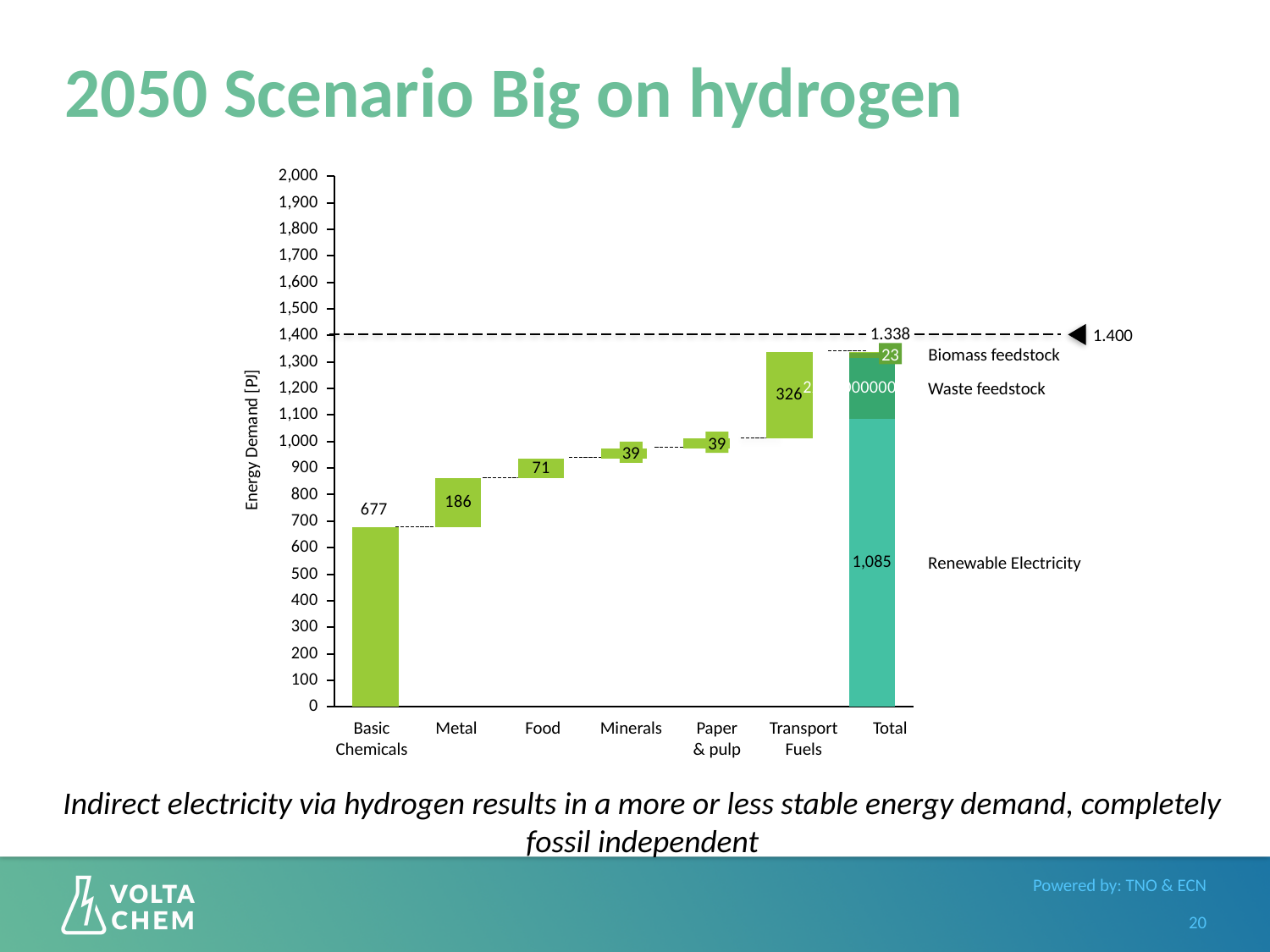
Which sector has the highest energy demand value? Basic Chemicals Is the Total value greater or less than 1,400? less What is the value shown above the Total bar? 1.338 What is the value for Basic Chemicals? 677 What is the value for Transport Fuels? 326 What is the Biomass feedstock value in the Total bar? 23 What is the Renewable Electricity value in the Total bar? 1,085 How many categories are shown on the x axis? 7 What is the value for Metal? 186 Which is larger, the value for Transport Fuels or the value for Metal? Transport Fuels What is the difference between the values for Basic Chemicals and Metal? 491 What is the label of the y axis? Energy Demand [PJ]